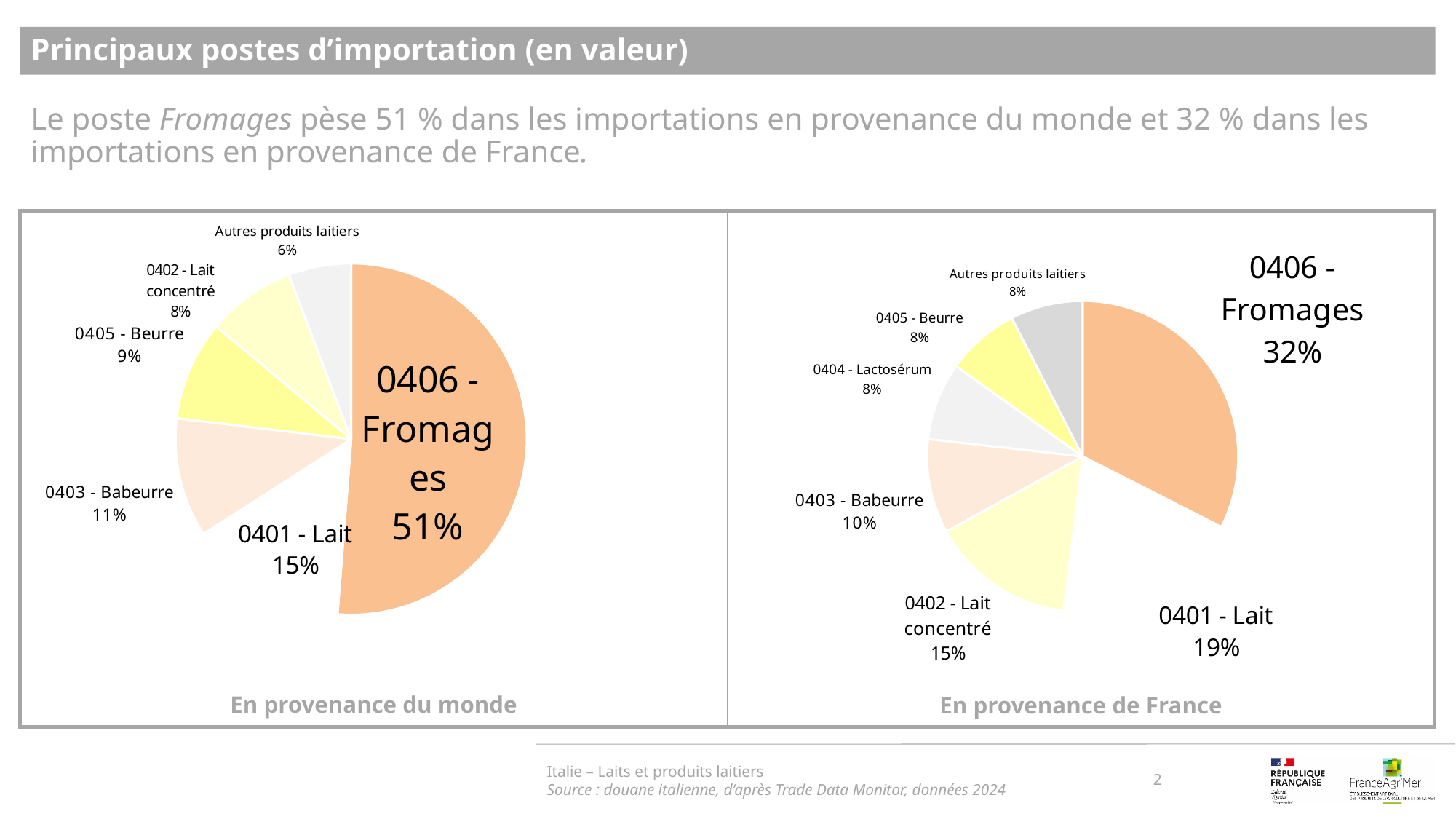
How many slices does the 'En provenance du monde' chart have? 6 In the 'En provenance de France' chart, what share does 0401 - Lait have? 19% In the 'En provenance du monde' chart, what share does 0406 - Fromages have? 51% In the 'En provenance du monde' chart, what share does 0403 - Babeurre have? 11% In the 'En provenance de France' chart, what share does 0402 - Lait concentré have? 15% In the 'En provenance du monde' chart, which category has the smallest share? Autres produits laitiers In the 'En provenance de France' chart, what share does 0404 - Lactosérum have? 8% In the 'En provenance de France' chart, which category has the largest share? 0406 - Fromages What type of chart is used in the 'En provenance du monde' panel? Pie chart What is the difference between the share of 0406 - Fromages in the 'En provenance du monde' chart and in the 'En provenance de France' chart? 19 percentage points In the 'En provenance du monde' chart, which is larger: 0405 - Beurre or 0402 - Lait concentré? 0405 - Beurre How many slices does the 'En provenance de France' chart have? 7